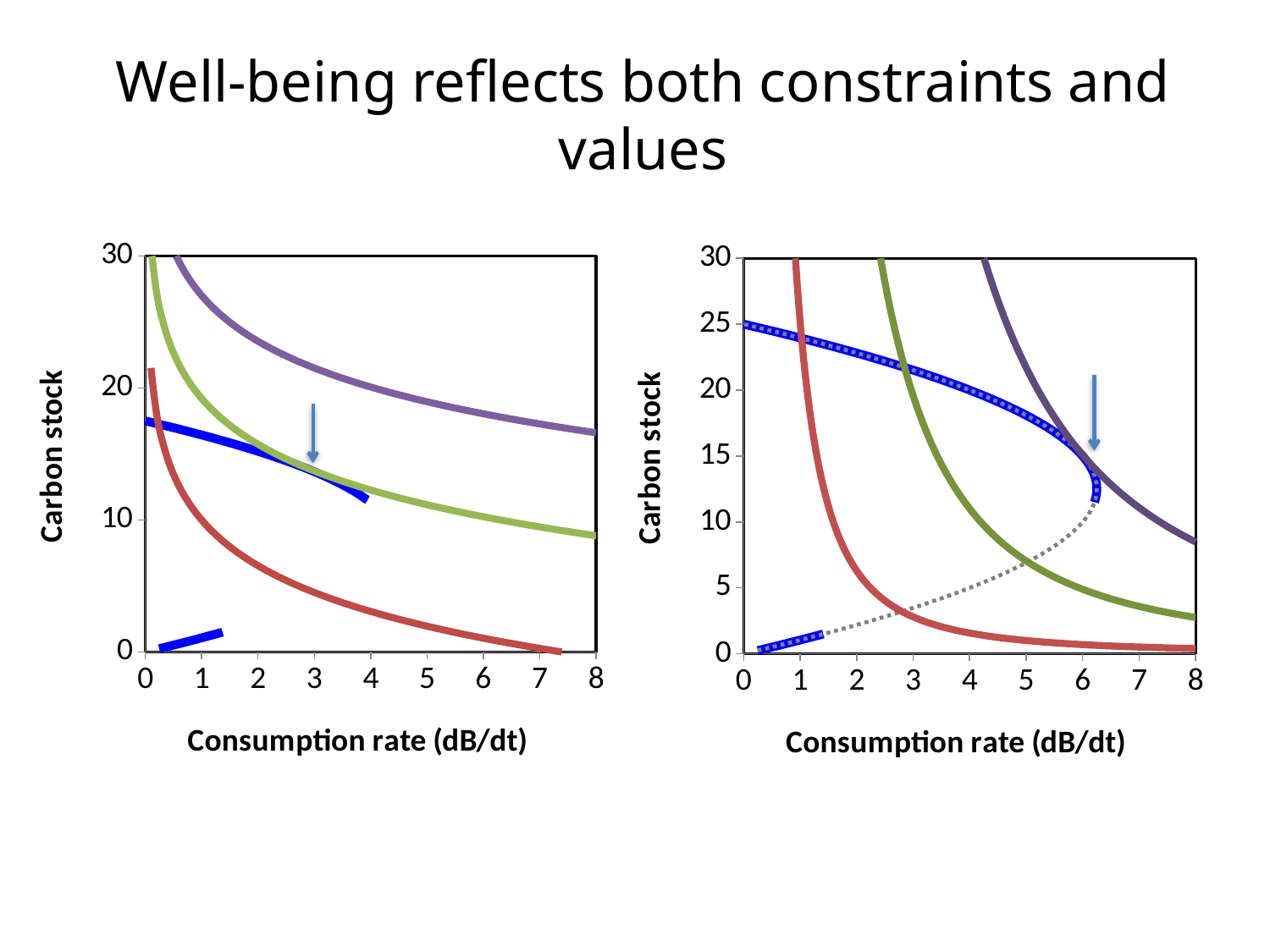
In the left chart, is the value of the purple curve at a consumption rate of 8 greater or less than 10? greater In the right chart, is the value of the blue dotted line at a consumption rate of 0 greater or less than 20? greater In the left chart, at a consumption rate of 8, which curve is higher: the purple curve or the green curve? purple curve In the right chart, is the value of the green curve at a consumption rate of 8 greater or less than 5? less In the left chart, does the purple curve rise or fall as consumption rate increases? fall What is the y-axis title of the right chart? Carbon stock In the right chart, at a consumption rate of 8, which curve is higher: the purple curve or the red curve? purple curve What is the x-axis title of the left chart? Consumption rate (dB/dt) In the right chart, does the grey dotted curve rise or fall as consumption rate increases? rise What type of chart is the left chart on the slide? line chart